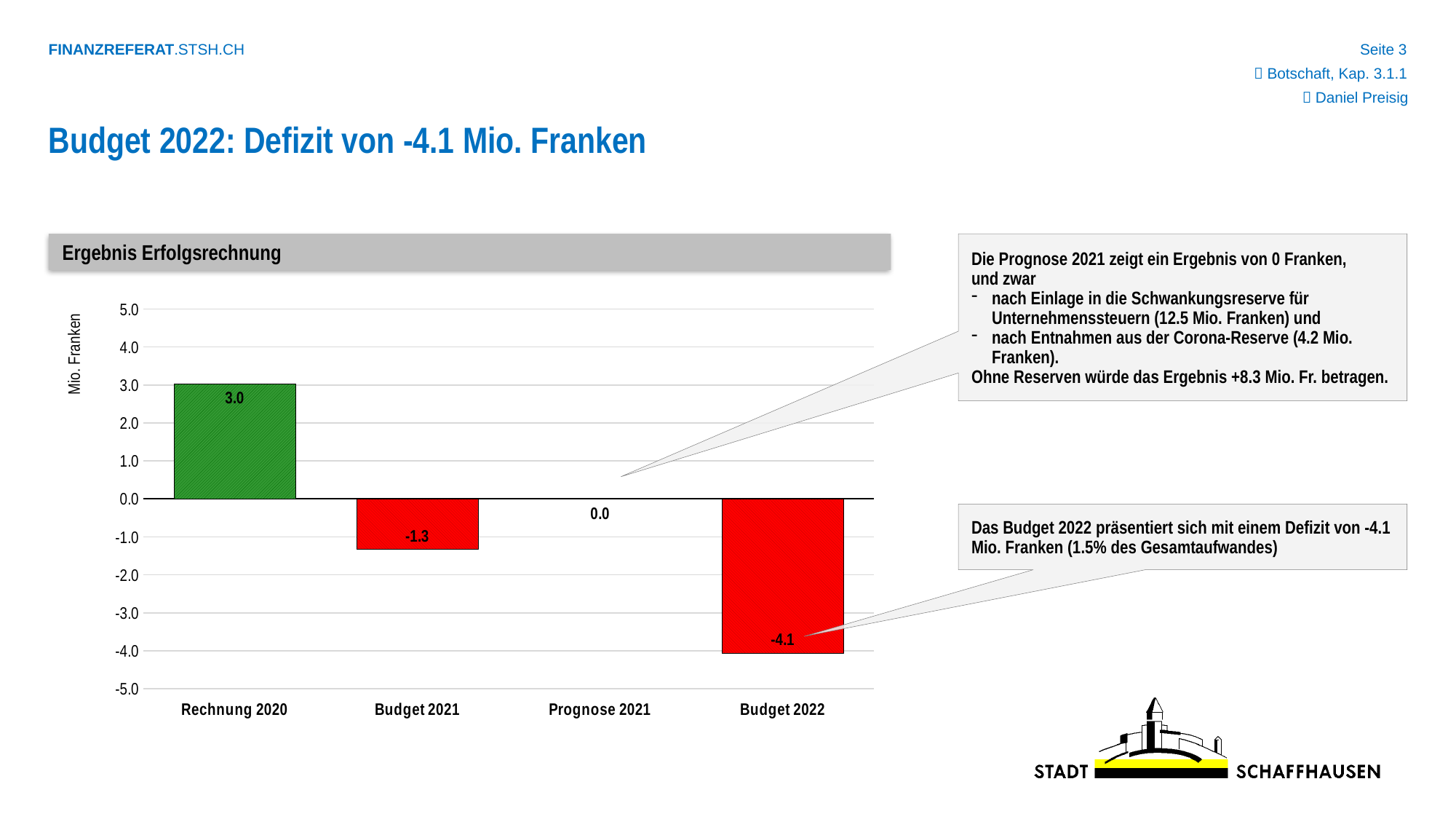
What kind of chart is shown on the slide? Bar chart What is the title of the chart? Ergebnis Erfolgsrechnung What is the value for Budget 2022? -4.1 How many categories are shown on the x axis? 4 Which category has the lowest value? Budget 2022 What is the value for Budget 2021? -1.3 Which is larger, the value for Budget 2021 or the value for Budget 2022? Budget 2021 What is the difference between the values for Rechnung 2020 and Budget 2022? 7.1 What is the value for Rechnung 2020? 3.0 What unit is shown on the y axis label? Mio. Franken What is the value for Prognose 2021? 0.0 Which category has the highest value? Rechnung 2020